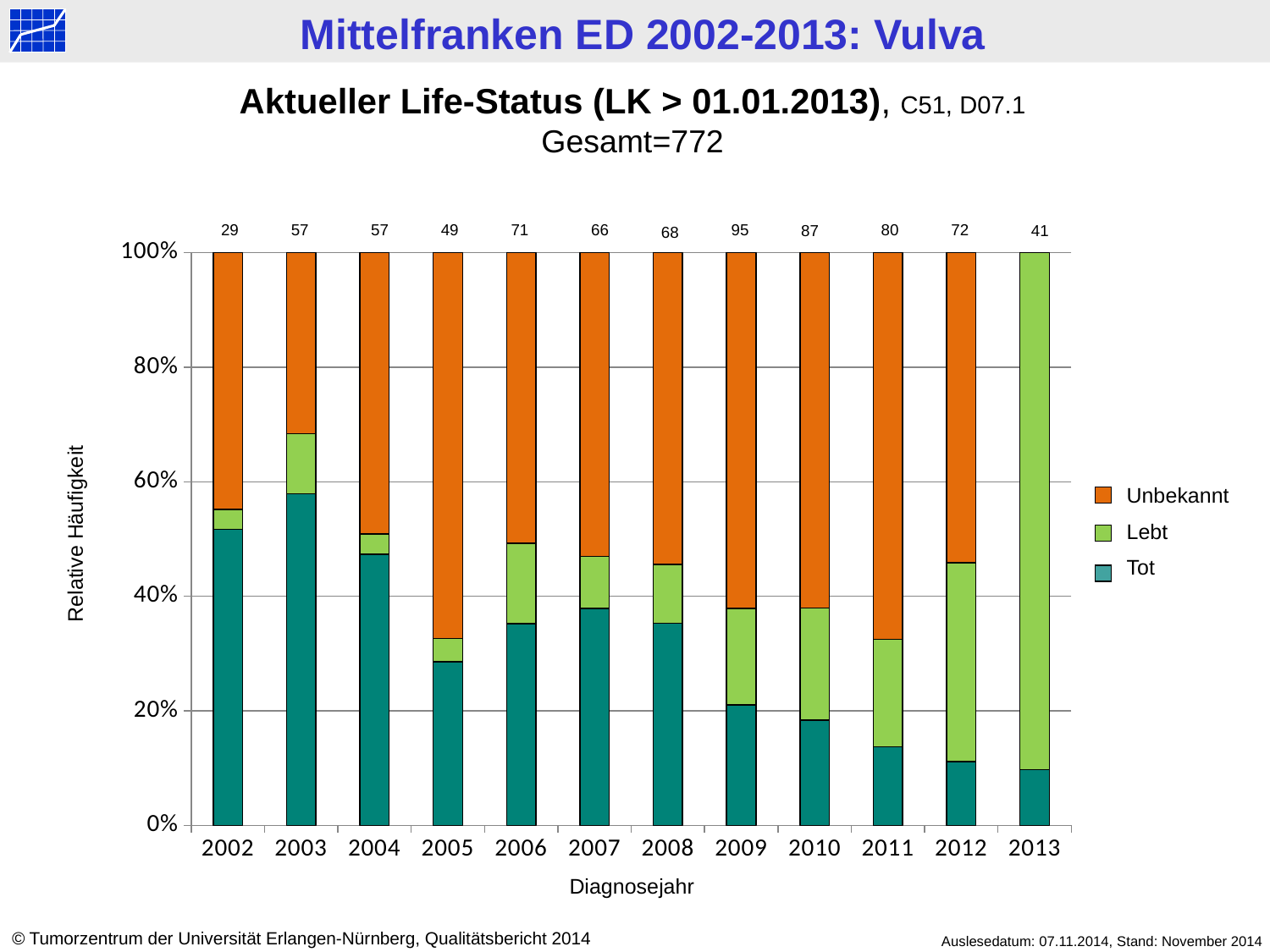
Which year has the larger number printed above its bar, 2010 or 2011? 2010 What number is printed above the bar for 2013? 41 Is the Tot share of the 2013 bar greater or less than 20%? less Which diagnosis year has the lowest number printed above its bar? 2002 Which diagnosis year has the highest number printed above its bar? 2009 How many series does the legend list? 3 What number is printed above the bar for 2002? 29 Is the Tot share of the 2003 bar greater or less than 40%? greater How many diagnosis years are shown on the x axis? 12 What is the difference between the numbers printed above the bars for 2009 and 2002? 66 What kind of chart is shown on the slide? Stacked bar chart What number is printed above the bar for 2009? 95